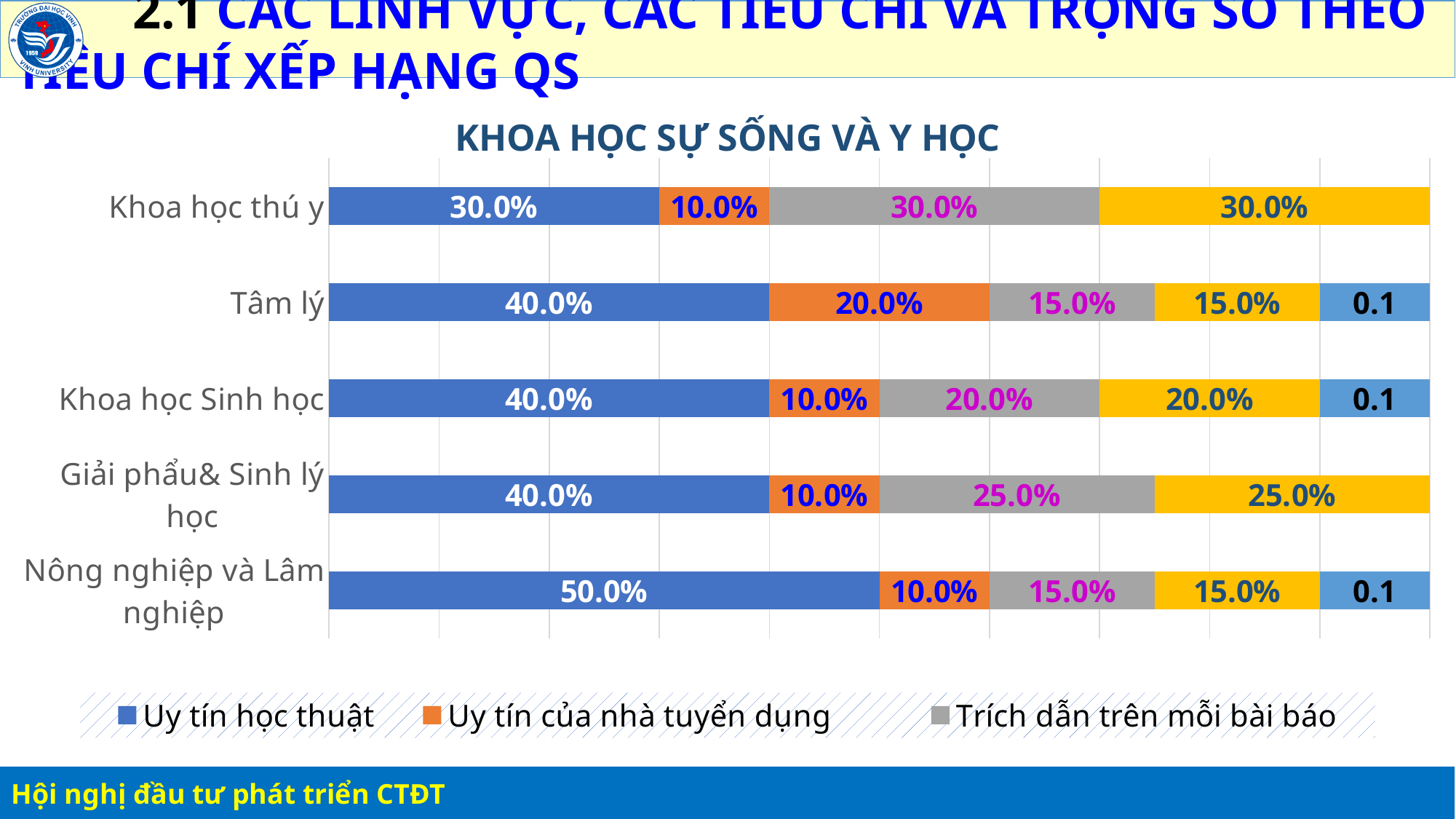
Which has the larger Trích dẫn trên mỗi bài báo value, Khoa học thú y or Tâm lý? Khoa học thú y How many categories are shown on the chart? 5 What type of chart is shown on the slide? Stacked bar chart How many series does the visible legend list? 3 Which category has the highest value for Uy tín của nhà tuyển dụng? Tâm lý Which category has the lowest value for Uy tín học thuật? Khoa học thú y What is the value of Uy tín học thuật for Nông nghiệp và Lâm nghiệp? 50.0% What is the value of Trích dẫn trên mỗi bài báo for Giải phẩu& Sinh lý học? 25.0% What is the title of the chart? KHOA HỌC SỰ SỐNG VÀ Y HỌC Which category has the highest value for Uy tín học thuật? Nông nghiệp và Lâm nghiệp What is the value of Uy tín của nhà tuyển dụng for Tâm lý? 20.0% What is the difference between the Uy tín học thuật values for Nông nghiệp và Lâm nghiệp and Khoa học thú y? 20.0%